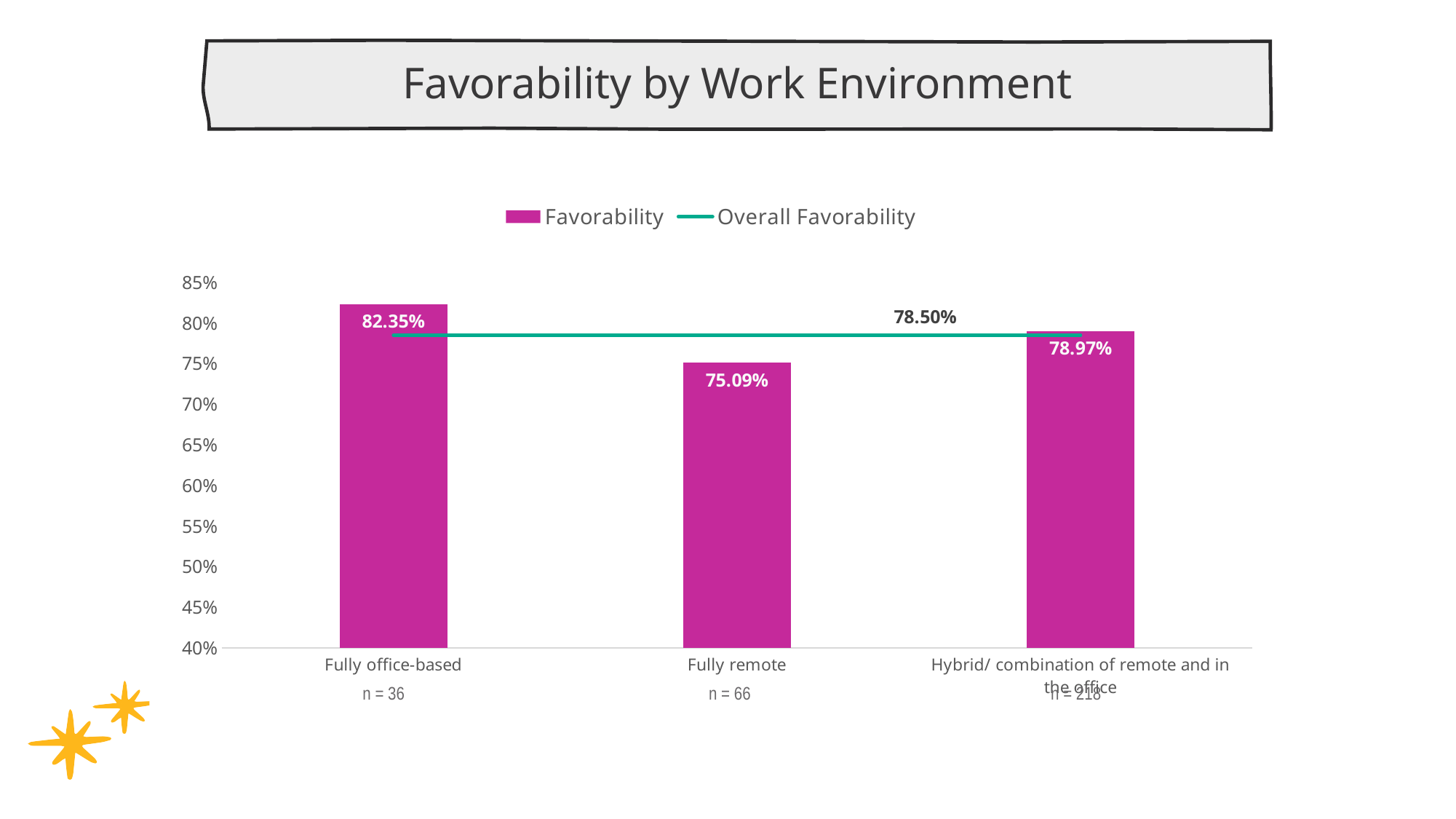
What is the Overall Favorability value shown on the chart? 78.50% What is the Favorability value for Fully office-based? 82.35% What is the Favorability value for Hybrid/ combination of remote and in the office? 78.97% Is the Favorability value for Fully remote greater or less than 80%? less Which has a higher Favorability: Fully remote or Hybrid/ combination of remote and in the office? Hybrid/ combination of remote and in the office What is the Favorability value for Fully remote? 75.09% Which work environment has the highest Favorability? Fully office-based How many series does the legend list? 2 What is the difference in Favorability between Fully office-based and Fully remote? 7.26% What is the title of the chart? Favorability by Work Environment How many work environment categories are shown on the chart? 3 Which work environment has the lowest Favorability? Fully remote